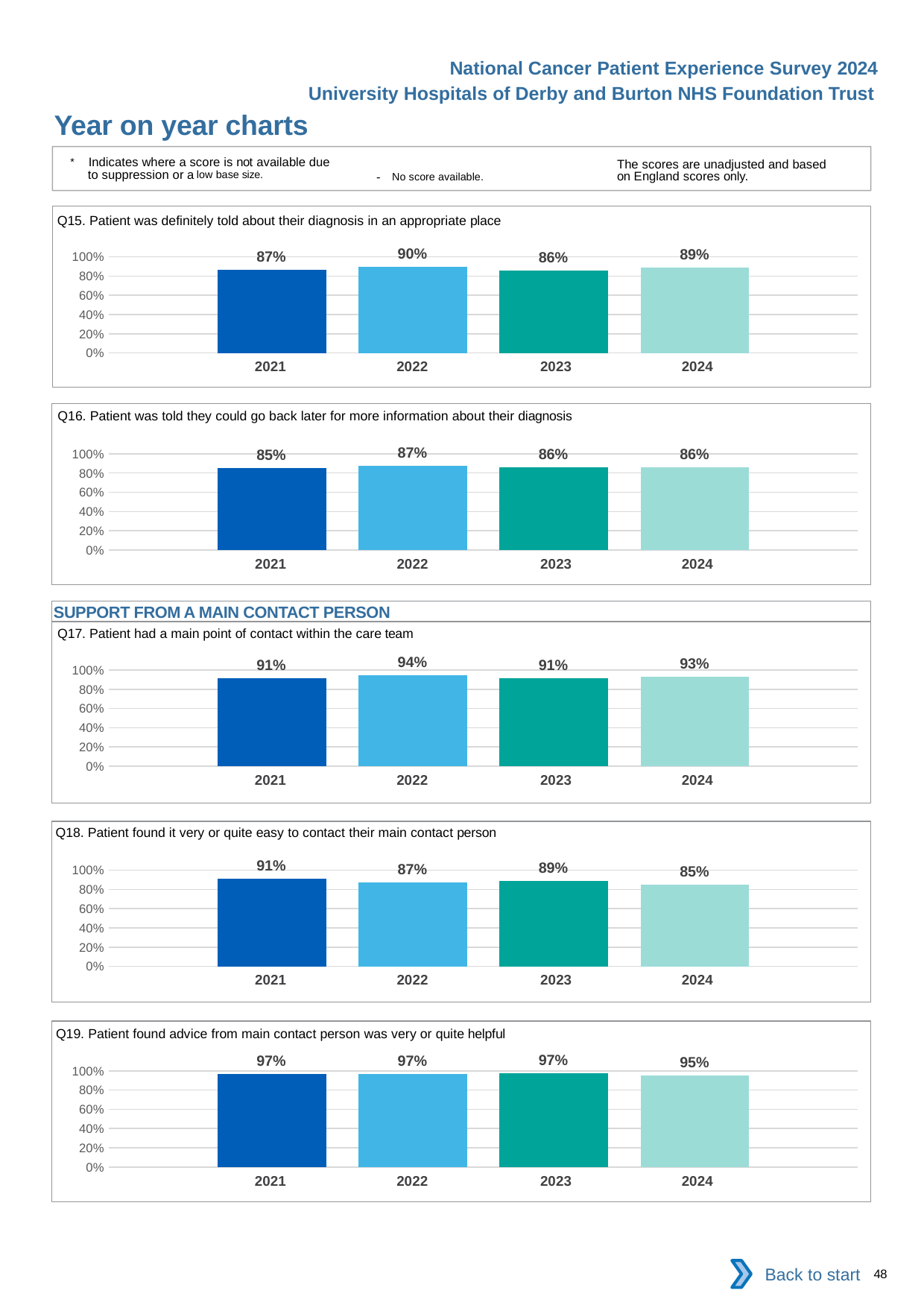
In the Q19 chart, how many years are plotted? 4 In the Q18 chart, do the values generally rise or fall from 2021 to 2024? fall In the Q17 chart (Patient had a main point of contact within the care team), what is the difference between the 2022 and 2021 values? 3% In the Q17 chart, which is larger, the value for 2023 or the value for 2024? 2024 In the Q16 chart (Patient was told they could go back later for more information about their diagnosis), what is the value for 2021? 85% In the Q18 chart (Patient found it very or quite easy to contact their main contact person), what is the value for 2024? 85% In the Q19 chart (Patient found advice from main contact person was very or quite helpful), what is the difference between the 2023 and 2024 values? 2% In the Q15 chart (Patient was definitely told about their diagnosis in an appropriate place), what is the value for 2022? 90% In the Q15 chart, which year has the lowest value? 2023 What type of chart is the Q15 chart? bar chart How many charts are shown on the slide? 5 In the Q16 chart, which year has the highest value? 2022